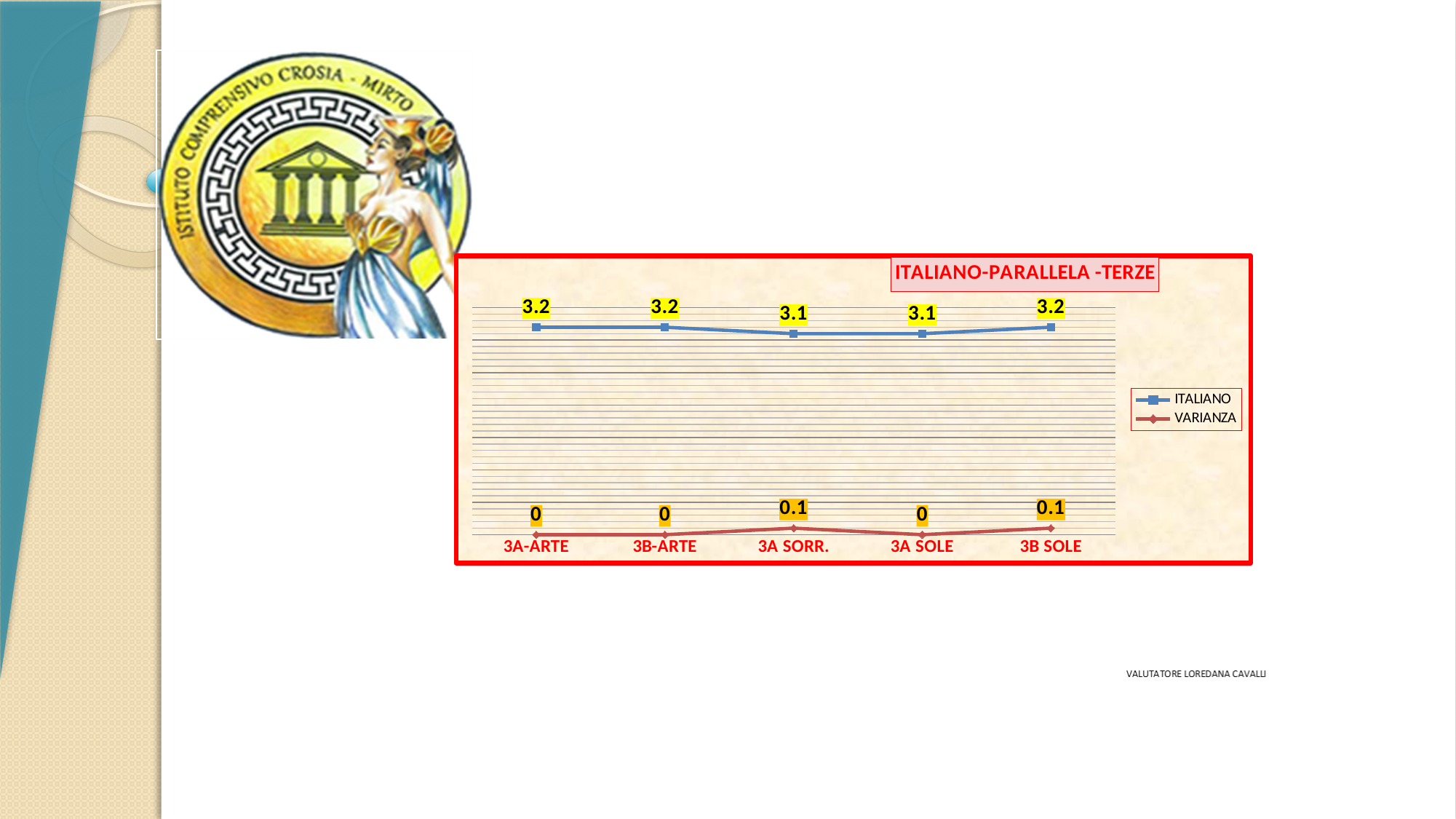
How many series does the legend list? 2 What is the difference between the ITALIANO values for 3A-ARTE and 3A SORR.? 0.1 What is the ITALIANO value for 3B-ARTE? 3.2 What is the ITALIANO value for 3A SORR.? 3.1 How many categories are shown on the x axis? 5 What is the VARIANZA value for 3A SOLE? 0 What is the VARIANZA value for 3B SOLE? 0.1 What is the title of the chart? ITALIANO-PARALLELA -TERZE Which categories have the lowest ITALIANO value? 3A SORR. and 3A SOLE What kind of chart is shown? line chart Is the ITALIANO value for 3B SOLE larger or smaller than the ITALIANO value for 3A SOLE? larger Which categories have the highest VARIANZA value? 3A SORR. and 3B SOLE